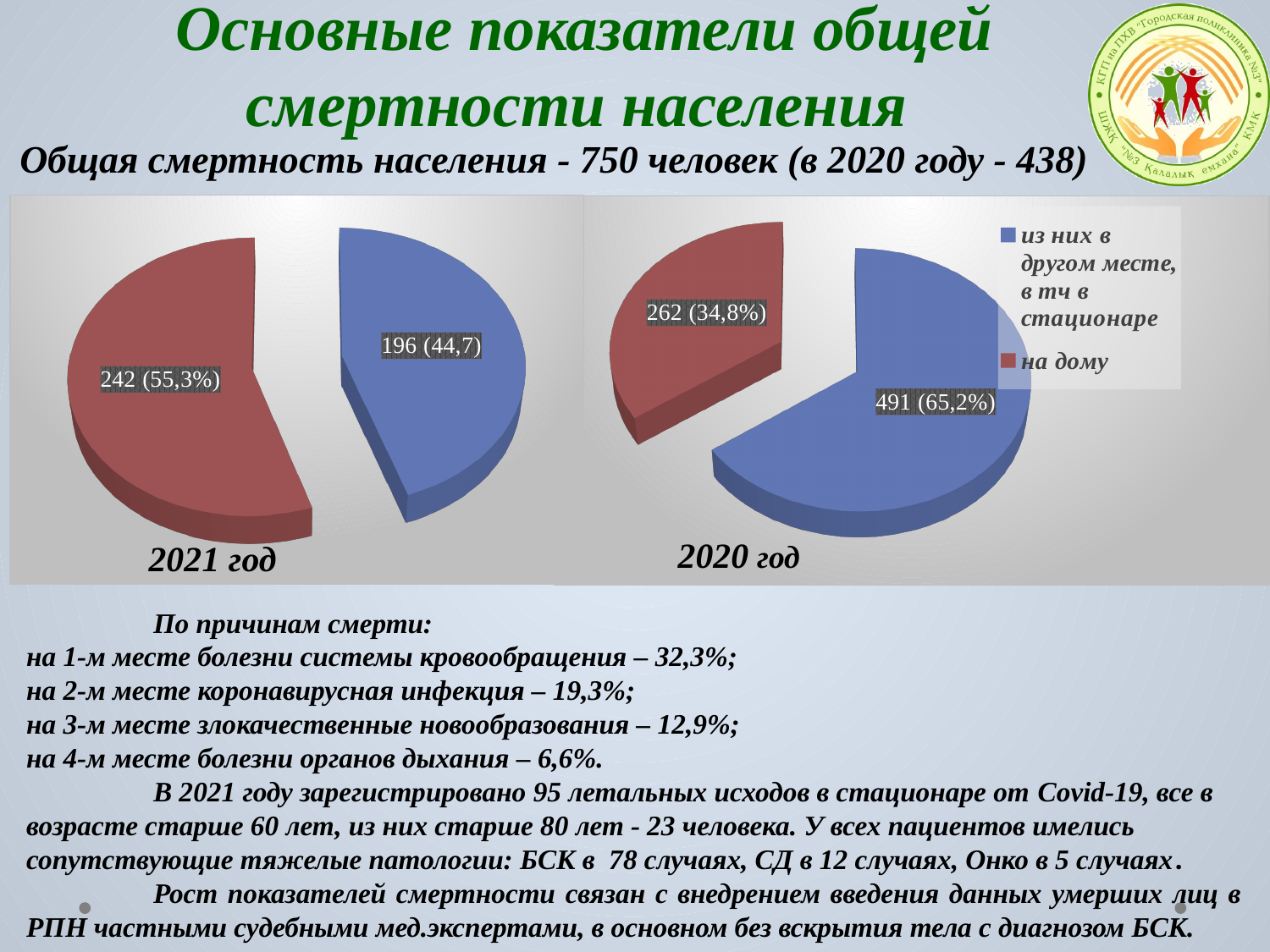
In the pie chart labelled "2020 год", what value is shown for the "из них в другом месте, в тч в стационаре" slice? 491 (65,2%) In the pie chart labelled "2021 год", which category has the largest slice? на дому How many entries does the legend list for the pie charts? 2 In the pie chart labelled "2020 год", what share of the pie does "на дому" represent? 34,8% What type of chart is used on this slide? Pie chart In the pie chart labelled "2020 год", what is the difference between the "из них в другом месте, в тч в стационаре" count and the "на дому" count? 229 In the pie chart labelled "2021 год", what value is shown for the "на дому" slice? 242 (55,3%) In the pie chart labelled "2020 год", what value is shown for the "на дому" slice? 262 (34,8%) In the pie chart labelled "2021 год", what is the difference between the "на дому" count and the "из них в другом месте, в тч в стационаре" count? 46 In the pie chart labelled "2021 год", what value is shown for the "из них в другом месте, в тч в стационаре" slice? 196 (44,7) In the pie chart labelled "2020 год", which is larger: "на дому" or "из них в другом месте, в тч в стационаре"? из них в другом месте, в тч в стационаре In the pie chart labelled "2020 год", which category has the largest slice? из них в другом месте, в тч в стационаре